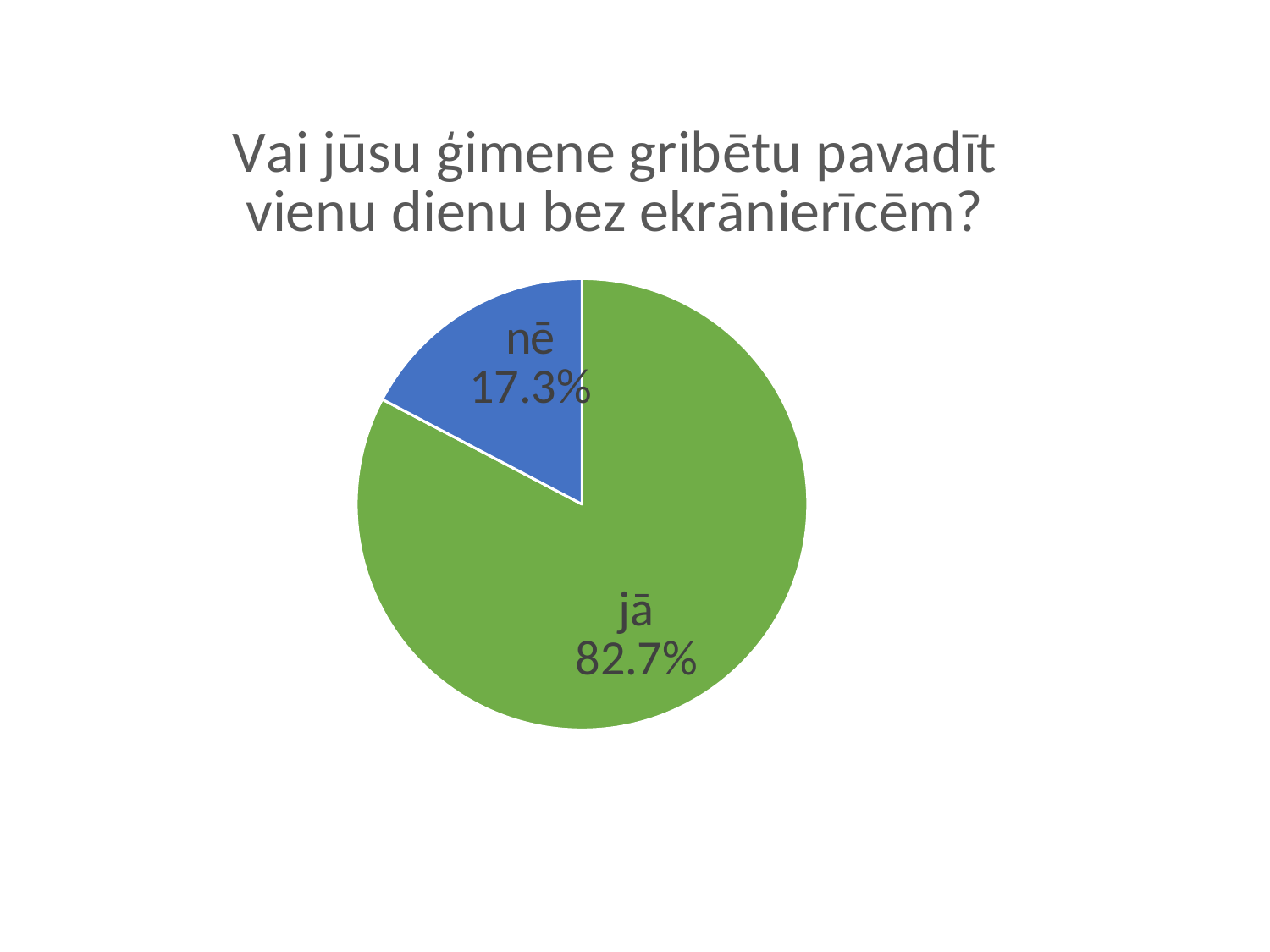
What kind of chart is shown on the slide? pie chart What is the title of the chart? Vai jūsu ģimene gribētu pavadīt vienu dienu bez ekrānierīcēm? How many slices does the pie chart have? 2 What percentage of the pie is the "nē" slice? 17.3% What is the difference in percentage points between the "jā" and "nē" slices? 65.4 Which slice is the smallest in the pie chart? nē What percentage of the pie is the "jā" slice? 82.7% What colour is the "jā" slice? green Which slice is larger, "jā" or "nē"? jā What share of the pie does the "nē" slice represent? 17.3% Which slice is the largest in the pie chart? jā